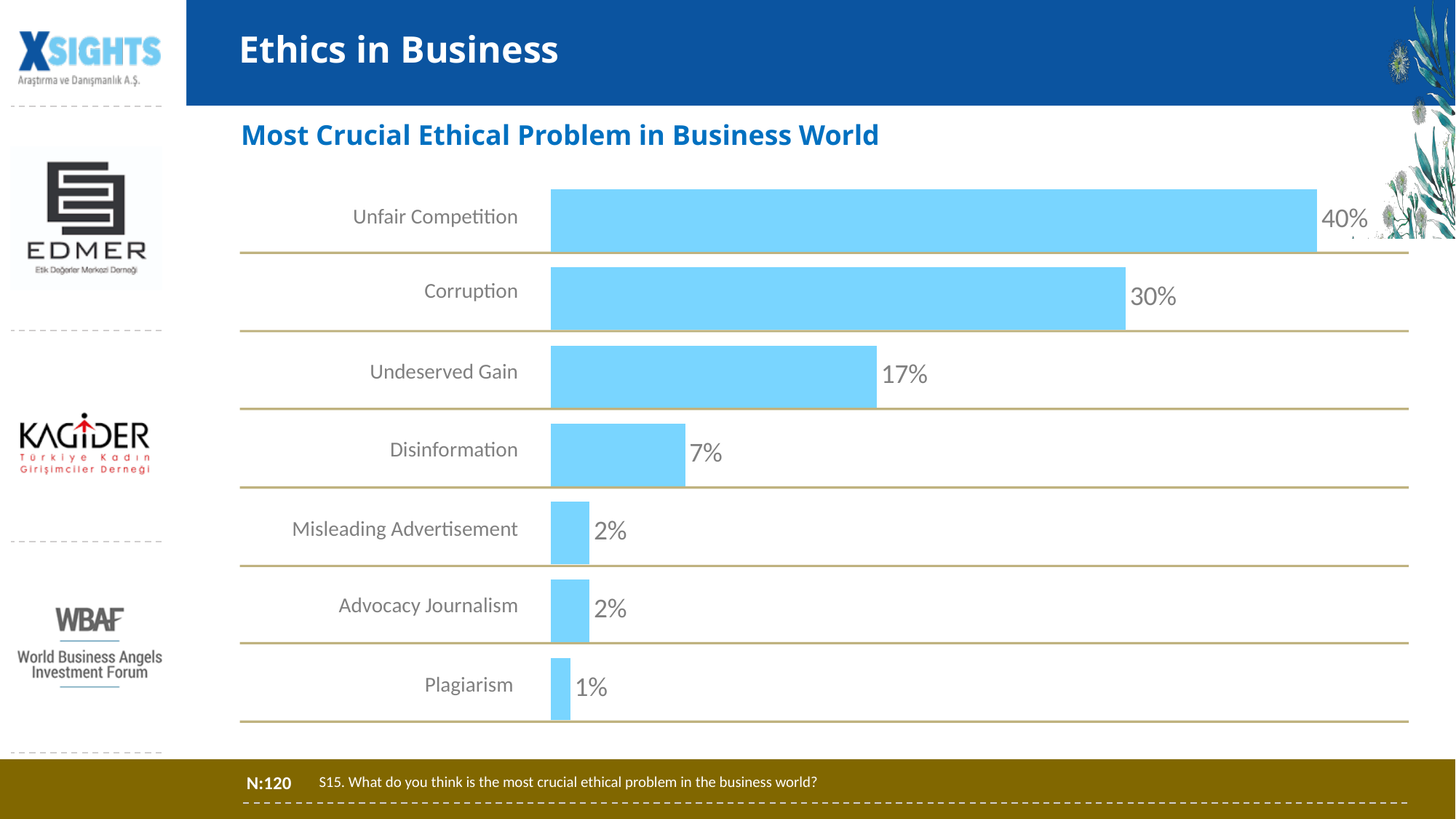
What percentage is shown for Undeserved Gain? 17% Which is larger, the value for Corruption or the value for Undeserved Gain? Corruption What is the difference between the values for Unfair Competition and Corruption? 10% Which category has the lowest value? Plagiarism Which category has the highest value? Unfair Competition What is the value for Disinformation? 7% What percentage is shown for Unfair Competition? 40% What kind of chart is shown on the slide? Bar chart What is the value for Corruption? 30% How many categories are shown in the chart? 7 What percentage is shown for Plagiarism? 1% What is the difference between the values for Undeserved Gain and Disinformation? 10%